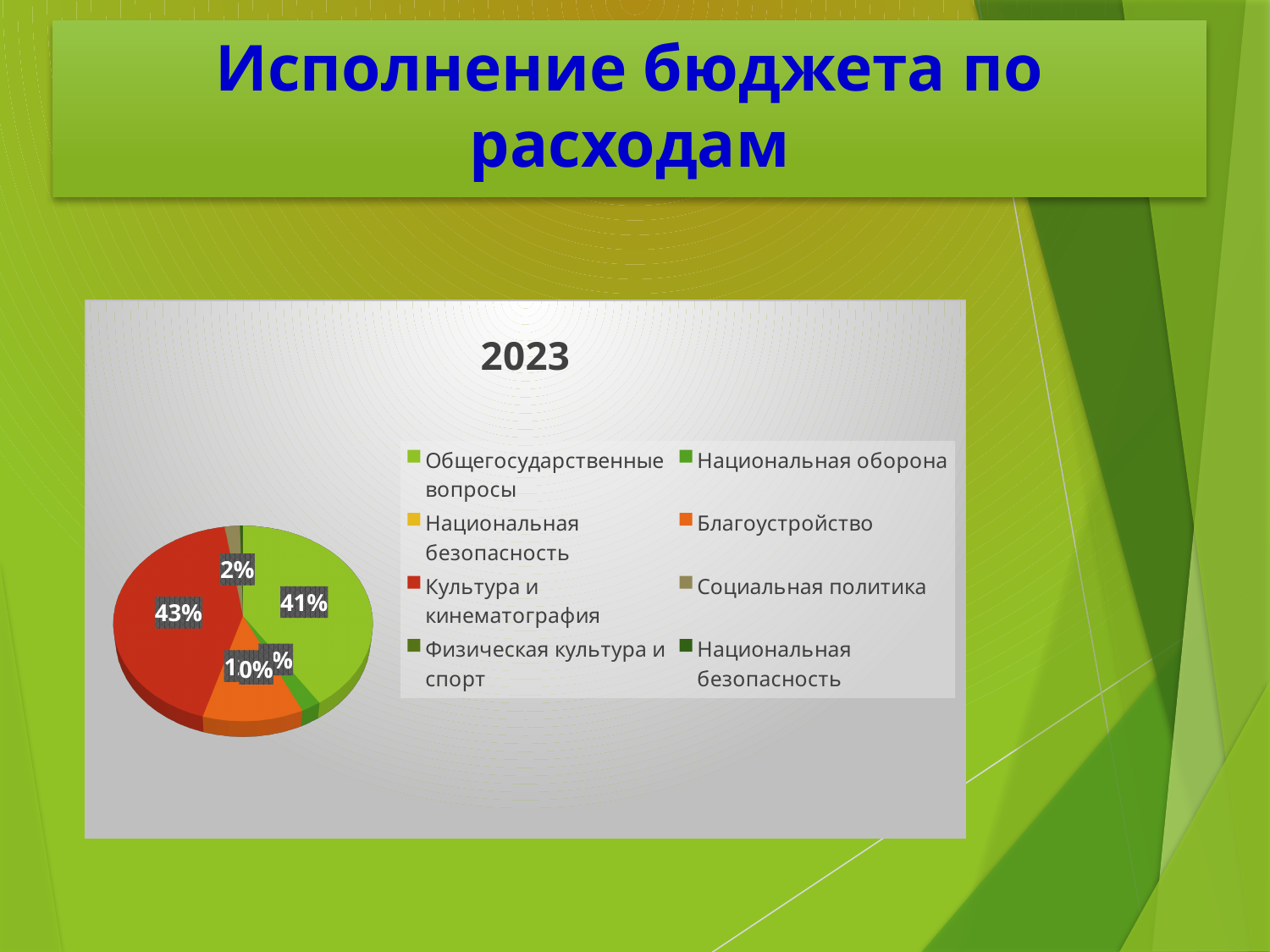
What is the title of the chart? 2023 What percentage of the pie is Социальная политика? 2% What percentage of the pie is Общегосударственные вопросы? 41% Which is larger: the share for Культура и кинематография or for Общегосударственные вопросы? Культура и кинематография Which is larger: the share for Благоустройство or for Социальная политика? Благоустройство What percentage of the pie is Культура и кинематография? 43% How many entries does the legend list? 8 By how many percentage points does Культура и кинематография exceed Общегосударственные вопросы? 2 percentage points Which category has the largest share of the pie? Культура и кинематография What colour is the slice for Культура и кинематография? red What kind of chart is shown on the slide? pie chart